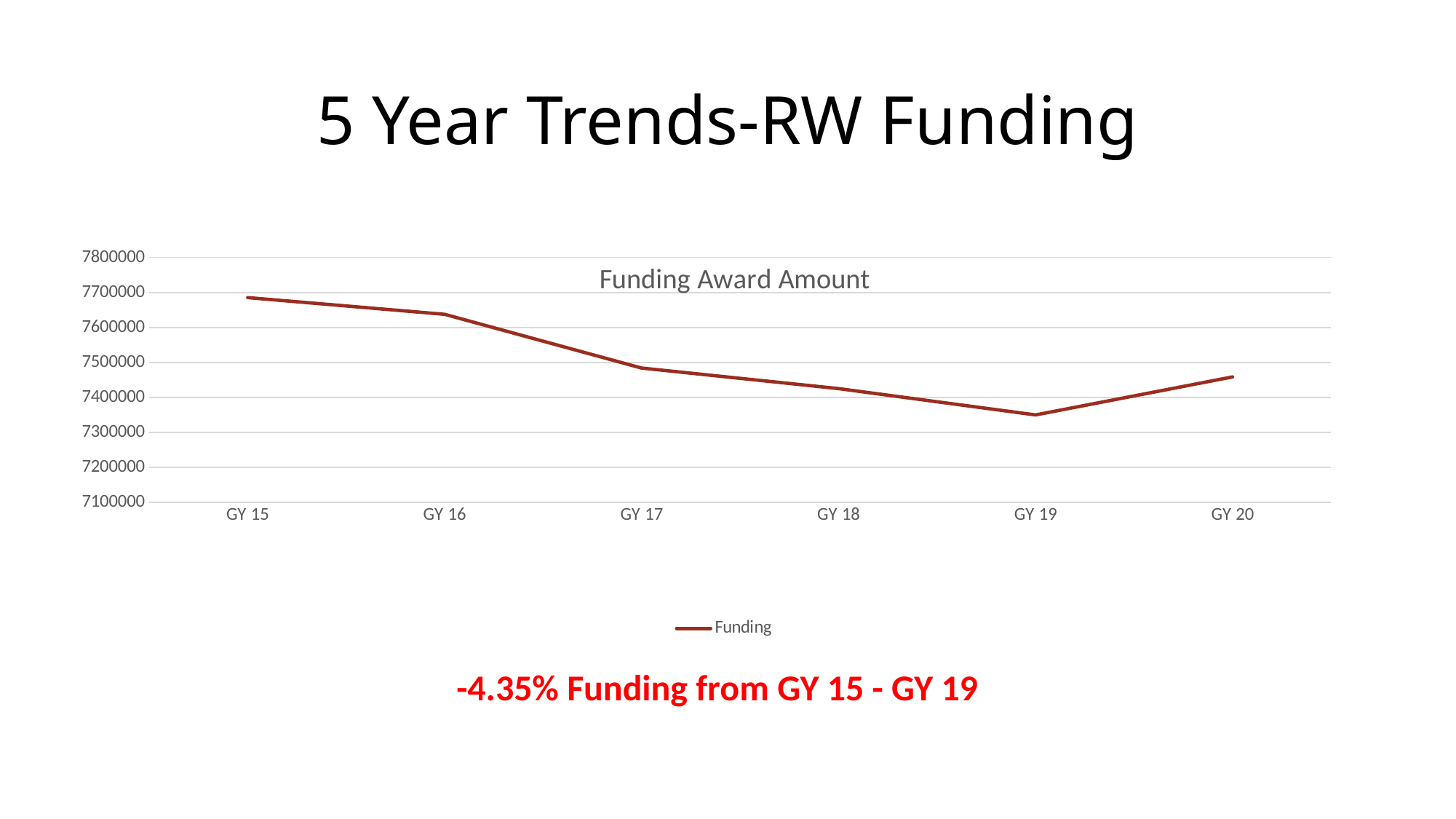
Is the funding value for GY 19 greater or less than 7400000? less What is the title of the chart? Funding Award Amount How many series does the legend list? 1 Which has the larger funding value, GY 16 or GY 17? GY 16 Is the funding value for GY 15 greater or less than 7600000? greater How many grant years are plotted on the x axis? 6 Is the funding value for GY 20 greater or less than 7400000? greater Which grant year has the lowest funding award amount? GY 19 What series name does the legend list? Funding What kind of chart is shown on the slide? line chart Which grant year has the highest funding award amount? GY 15 Do the funding values rise or fall from GY 15 to GY 19? fall